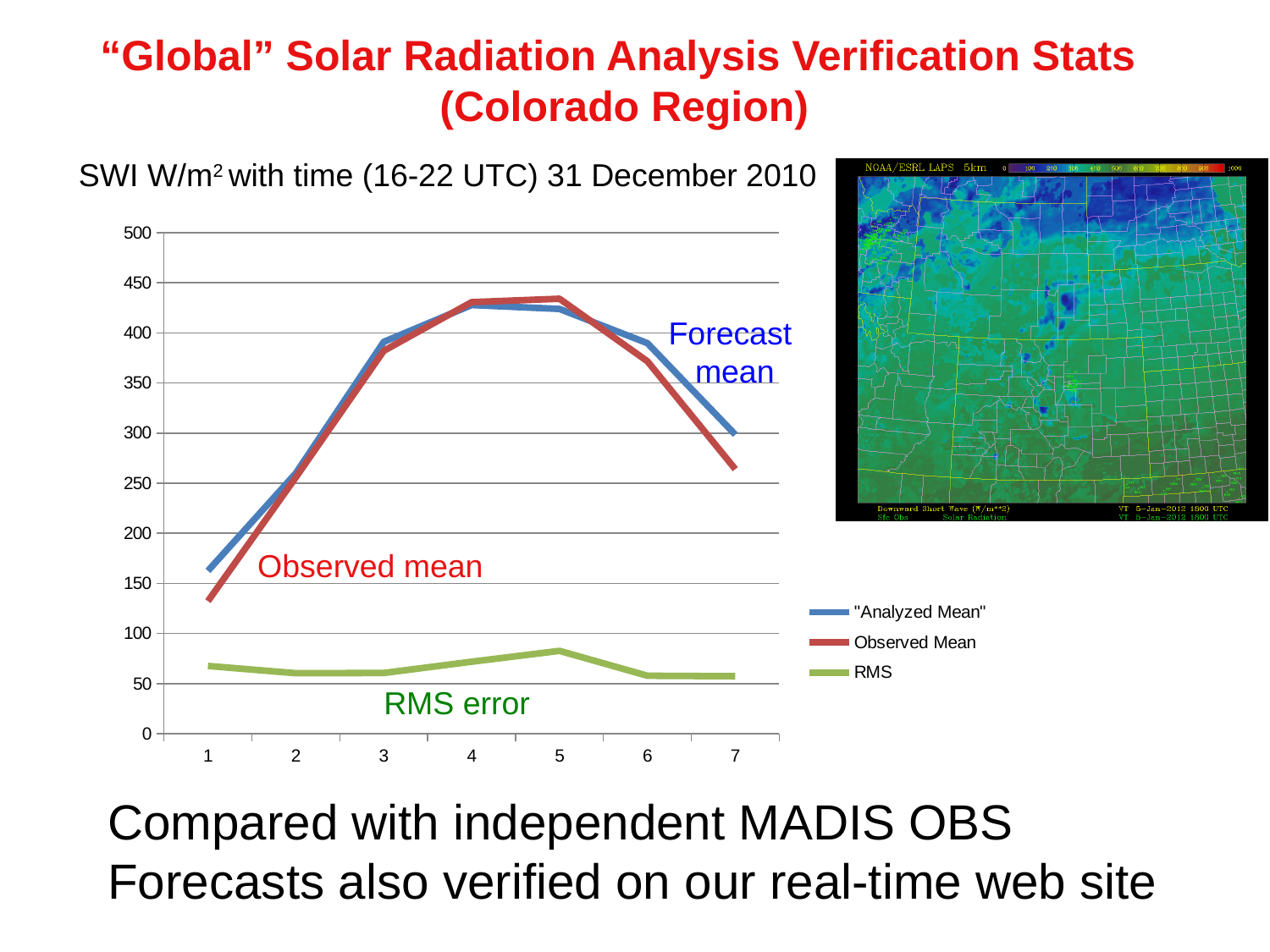
At point 1, which is larger: the "Analyzed Mean" value or the Observed Mean value? "Analyzed Mean" At which x-axis point is the "Analyzed Mean" series lowest? 1 What colour is the RMS line in the chart? green Is the value of the Observed Mean series at point 1 greater or less than 150? less Do the "Analyzed Mean" values rise or fall from point 1 to point 4? rise Is the value of the "Analyzed Mean" series at point 1 greater or less than 150? greater At which x-axis point is the RMS series highest? 5 How many series does the legend list? 3 What kind of chart is shown on the slide? line chart How many points are plotted along the x axis for each series? 7 Is the value of the RMS series at point 5 greater or less than 100? less